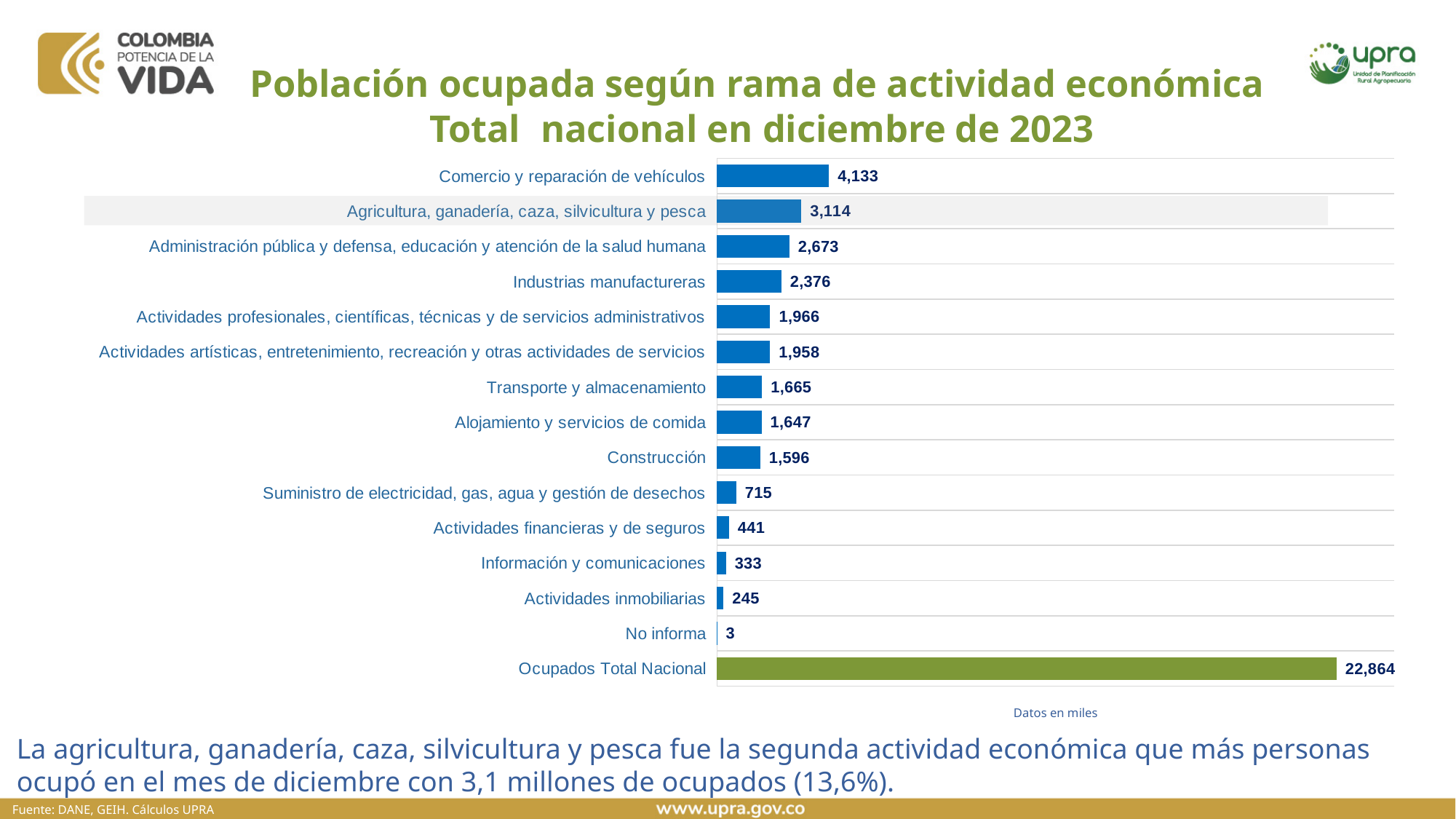
Which is larger, the value for Transporte y almacenamiento or the value for Alojamiento y servicios de comida? Transporte y almacenamiento What is the difference between the values for Industrias manufactureras and Construcción? 780 How many bars are shown in the chart? 15 What is the value for Ocupados Total Nacional? 22,864 What is the difference between the values for Comercio y reparación de vehículos and Agricultura, ganadería, caza, silvicultura y pesca? 1,019 Which bar is shown in a different colour (green) from the others? Ocupados Total Nacional What kind of chart is shown on the slide? Bar chart Excluding the Ocupados Total Nacional bar, which economic activity has the highest value? Comercio y reparación de vehículos What is the value for Comercio y reparación de vehículos? 4,133 Which category has the lowest value? No informa What is the value for Suministro de electricidad, gas, agua y gestión de desechos? 715 What is the value for Agricultura, ganadería, caza, silvicultura y pesca? 3,114